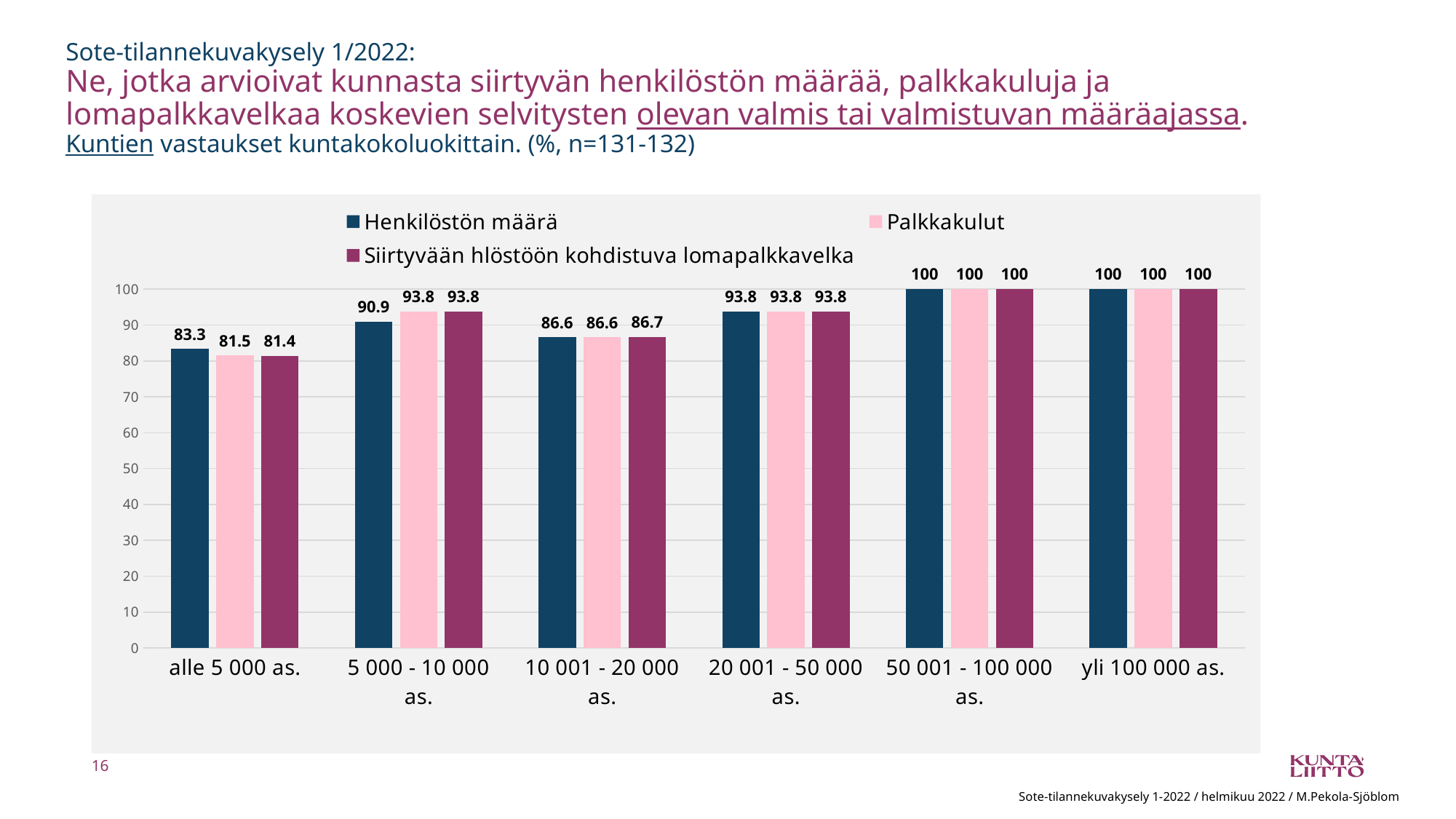
Which is larger: the Henkilöstön määrä value for '5 000 - 10 000 as.' or for '10 001 - 20 000 as.'? 5 000 - 10 000 as. How many series does the legend list? 3 Which series is shown in pink in the legend? Palkkakulut What is the value for Henkilöstön määrä in the 'alle 5 000 as.' category? 83.3 What is the difference between the Palkkakulut value for '5 000 - 10 000 as.' and for 'alle 5 000 as.'? 12.3 What is the difference between the Henkilöstön määrä value and the Palkkakulut value in the 'alle 5 000 as.' category? 1.8 Which category has the lowest value for Henkilöstön määrä? alle 5 000 as. What is the value for Siirtyvään hlöstöön kohdistuva lomapalkkavelka in the '10 001 - 20 000 as.' category? 86.7 What is the value for Palkkakulut in the 'alle 5 000 as.' category? 81.5 What is the value for Palkkakulut in the '5 000 - 10 000 as.' category? 93.8 What kind of chart is shown on the slide? bar chart How many categories are shown on the x axis? 6